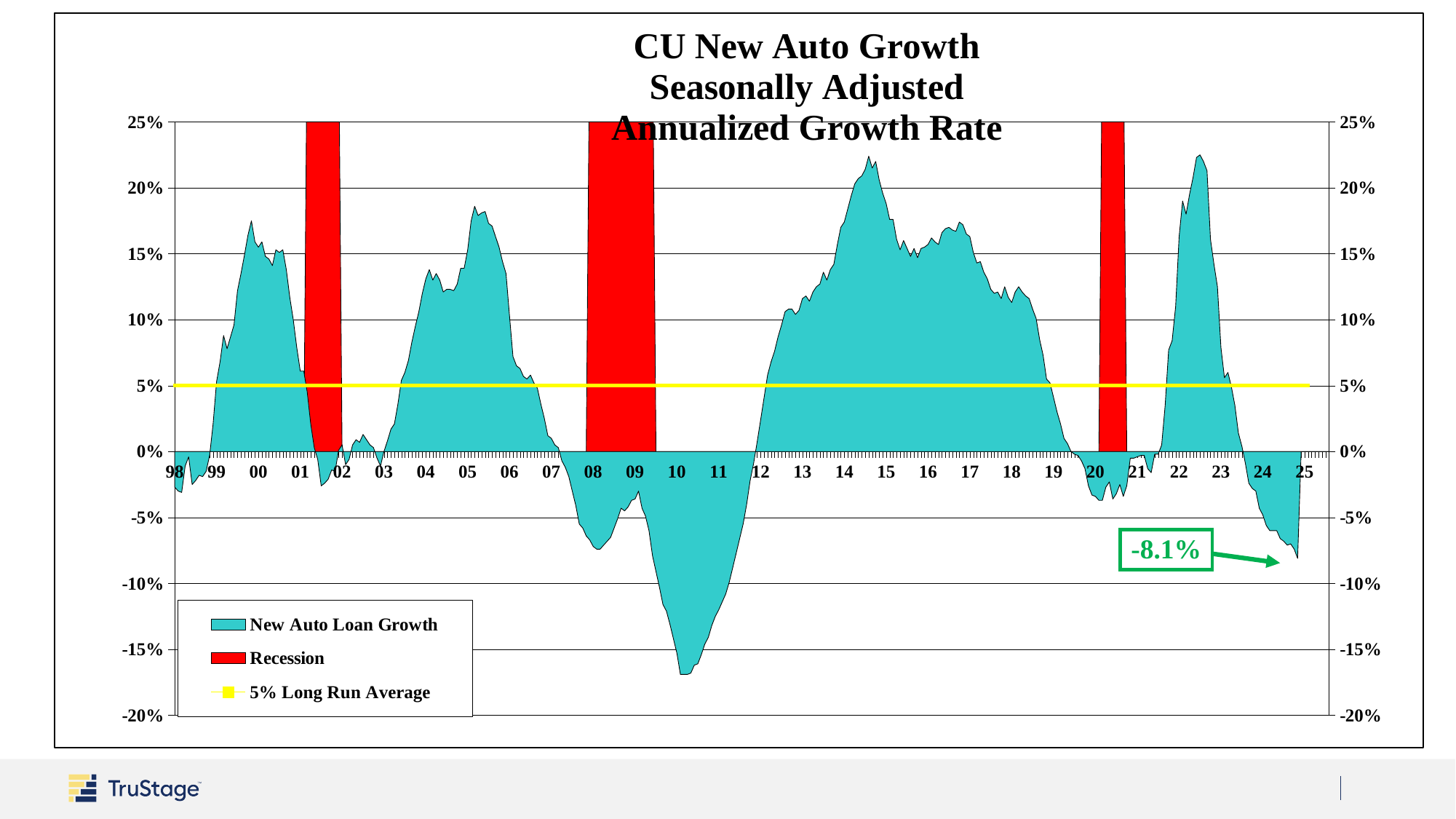
What value does the long run average line represent? 5% Is the New Auto Loan Growth value in 2011 greater or less than 0%? less Is the lowest New Auto Loan Growth value around 2010 greater or less than -15%? less How many recession periods are shaded on the chart? 3 In which year does New Auto Loan Growth reach its lowest point on the chart? 2010 What is the title of the chart? CU New Auto Growth Seasonally Adjusted Annualized Growth Rate Is the New Auto Loan Growth value in 2016 greater or less than 10%? greater What kind of chart is shown on the slide? Area chart What is the most recent New Auto Loan Growth value labeled on the chart? -8.1% How many entries does the chart's legend list? 3 Does New Auto Loan Growth rise or fall from 2023 to 2025? fall